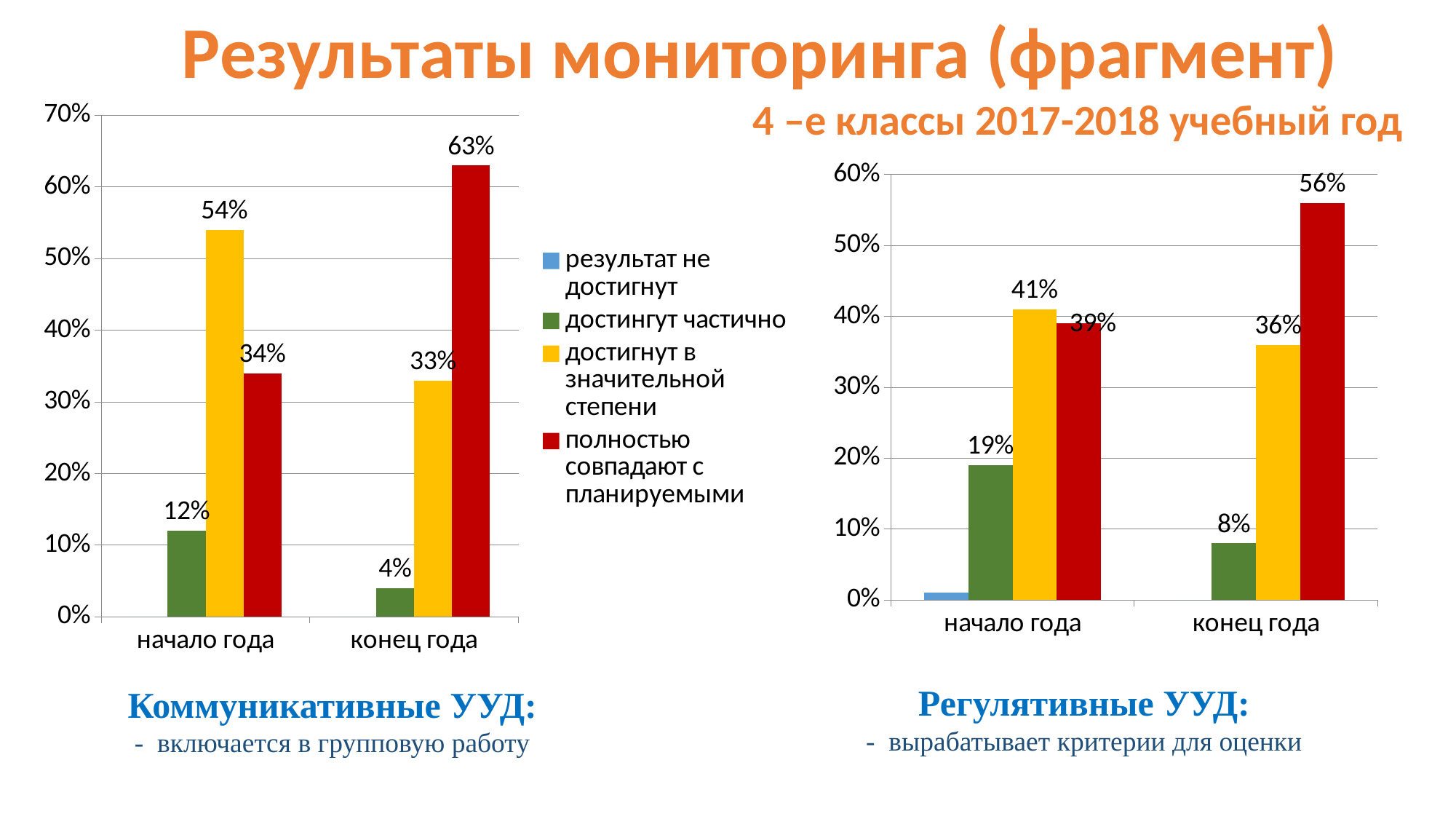
In the right chart (Регулятивные УУД), which is larger at 'начало года': 'достигнут в значительной степени' or 'полностью совпадают с планируемыми'? достигнут в значительной степени In the right chart (Регулятивные УУД), what is the difference between 'достингут частично' at 'начало года' and at 'конец года'? 11% How many series does the legend list? 4 In the right chart (Регулятивные УУД), what is the value for 'полностью совпадают с планируемыми' at 'конец года'? 56% In the left chart (Коммуникативные УУД), what is the value for 'полностью совпадают с планируемыми' at 'конец года'? 63% What kind of chart is the left chart (Коммуникативные УУД)? bar chart In the right chart (Регулятивные УУД), is the value for 'результат не достигнут' at 'начало года' greater or less than 10%? less In the left chart (Коммуникативные УУД), what is the difference between the 'полностью совпадают с планируемыми' values at 'конец года' and 'начало года'? 29% In the left chart (Коммуникативные УУД), what is the value for 'достигнут в значительной степени' at 'начало года'? 54% In the right chart (Регулятивные УУД), what is the value for 'достингут частично' at 'начало года'? 19% In the left chart (Коммуникативные УУД), which series has the highest value at 'начало года'? достигнут в значительной степени